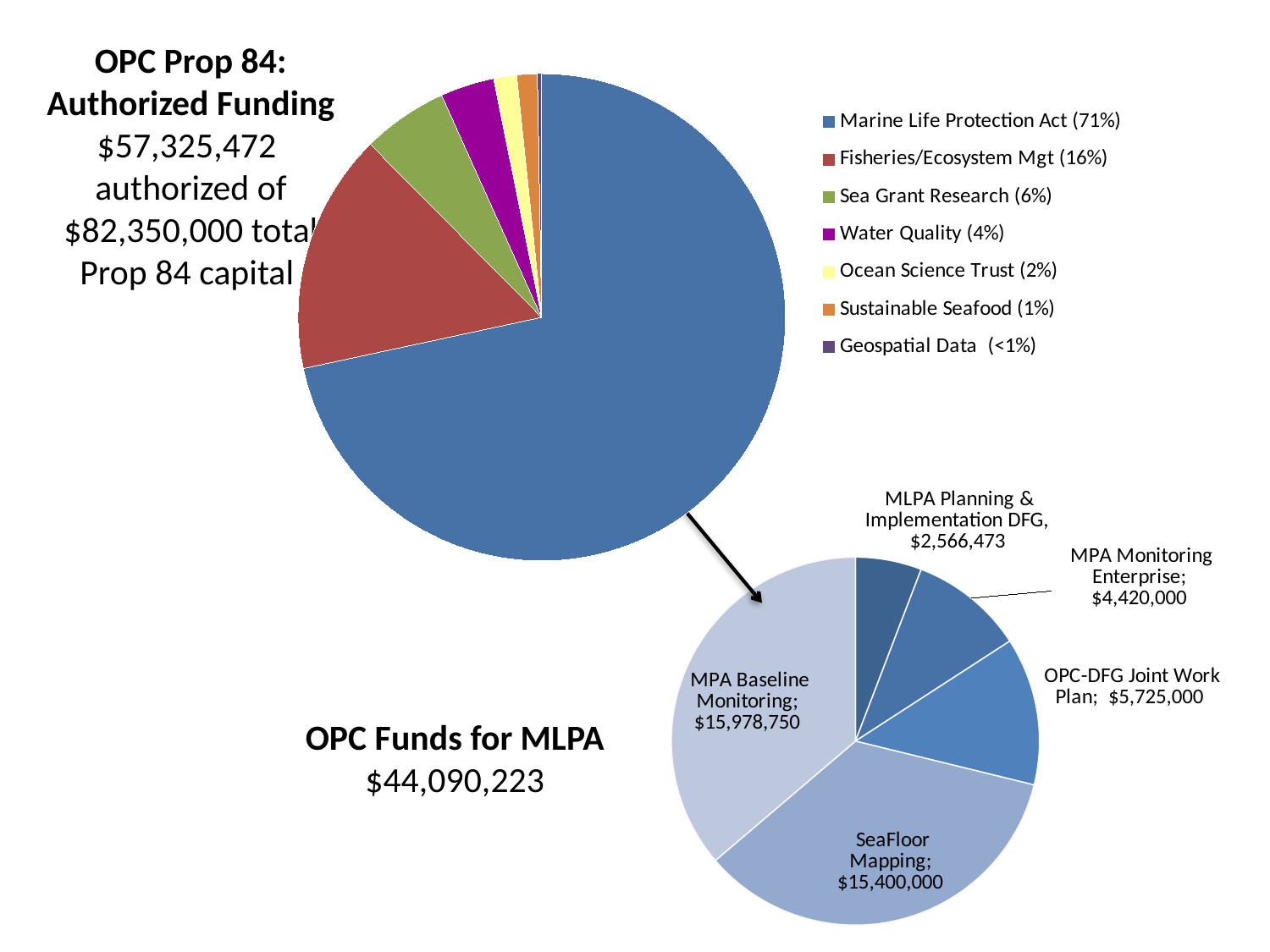
In the OPC Prop 84: Authorized Funding chart, which is larger, Sea Grant Research or Water Quality? Sea Grant Research How many categories does the legend of the OPC Prop 84: Authorized Funding chart list? 7 In the OPC Prop 84: Authorized Funding chart, which category has the smallest slice? Geospatial Data In the OPC Funds for MLPA chart, what is the difference between OPC-DFG Joint Work Plan and MLPA Planning & Implementation DFG? $3,158,527 In the OPC Funds for MLPA chart, what is the value for SeaFloor Mapping? $15,400,000 In the OPC Prop 84: Authorized Funding chart, which category has the largest slice? Marine Life Protection Act In the OPC Prop 84: Authorized Funding chart, what share of the pie is Fisheries/Ecosystem Mgt? 16% In the OPC Funds for MLPA chart, what is the value for MPA Monitoring Enterprise? $4,420,000 In the OPC Funds for MLPA chart, which category has the largest value? MPA Baseline Monitoring What kind of chart is the OPC Funds for MLPA chart? Pie chart In the OPC Funds for MLPA chart, which category has the smallest value? MLPA Planning & Implementation DFG In the OPC Prop 84: Authorized Funding chart, what share of the pie is Marine Life Protection Act? 71%